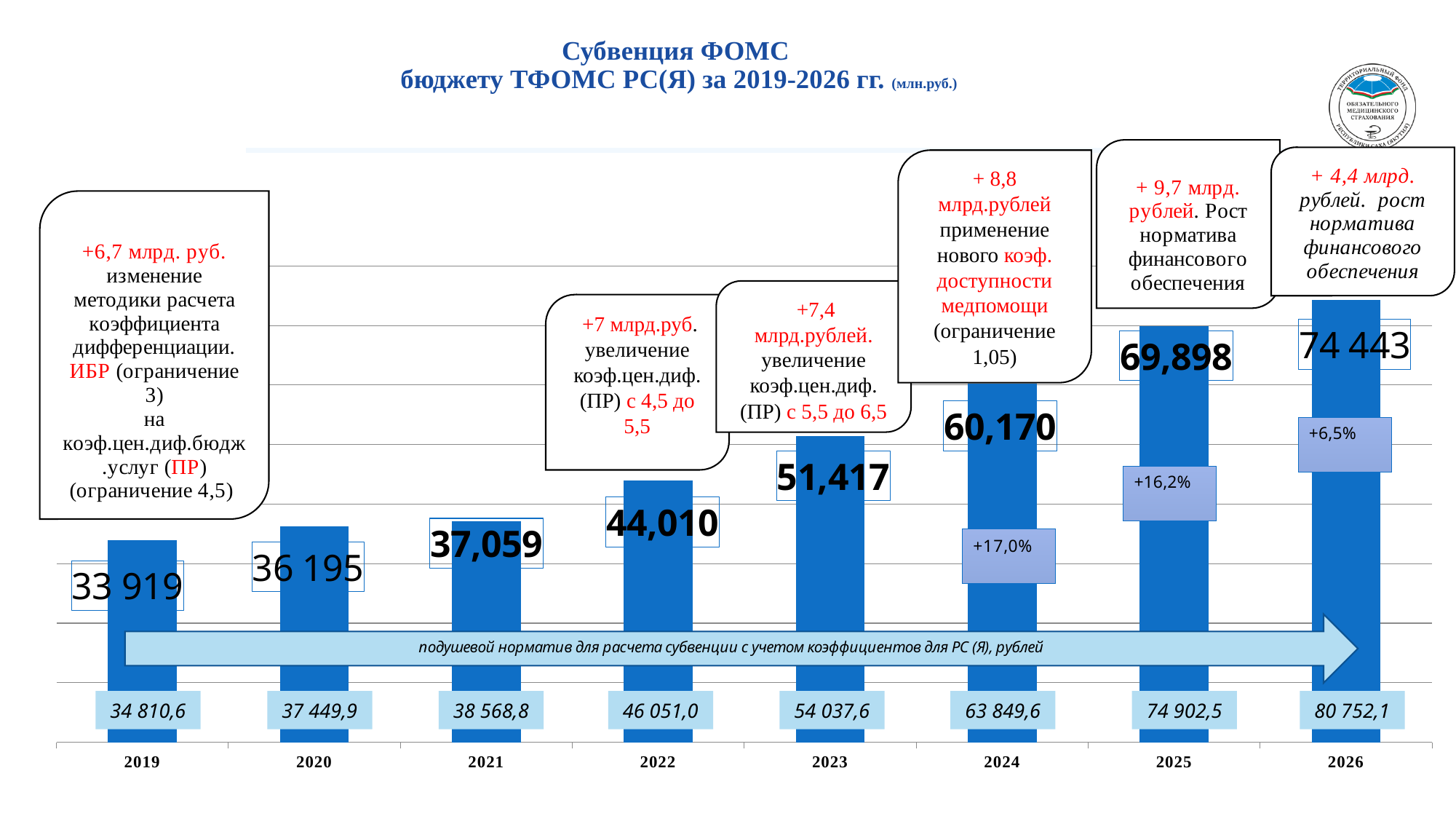
What is the difference between the bar values for 2026 and 2025? 4 545 What per-capita norm (подушевой норматив) is shown below the 2026 bar? 80 752,1 Which is larger, the bar for 2022 or the bar for 2021? 2022 Which year has the highest bar? 2026 What is the value of the bar for 2025? 69,898 What percentage growth is labelled on the 2024 bar? +17,0% What is the value of the bar for 2019? 33 919 Do the bar values rise or fall from 2019 to 2026? Rise What kind of chart is shown on the slide? Bar chart What is the value of the bar for 2023? 51,417 How many years (bars) are shown on the chart? 8 Which year has the lowest bar? 2019